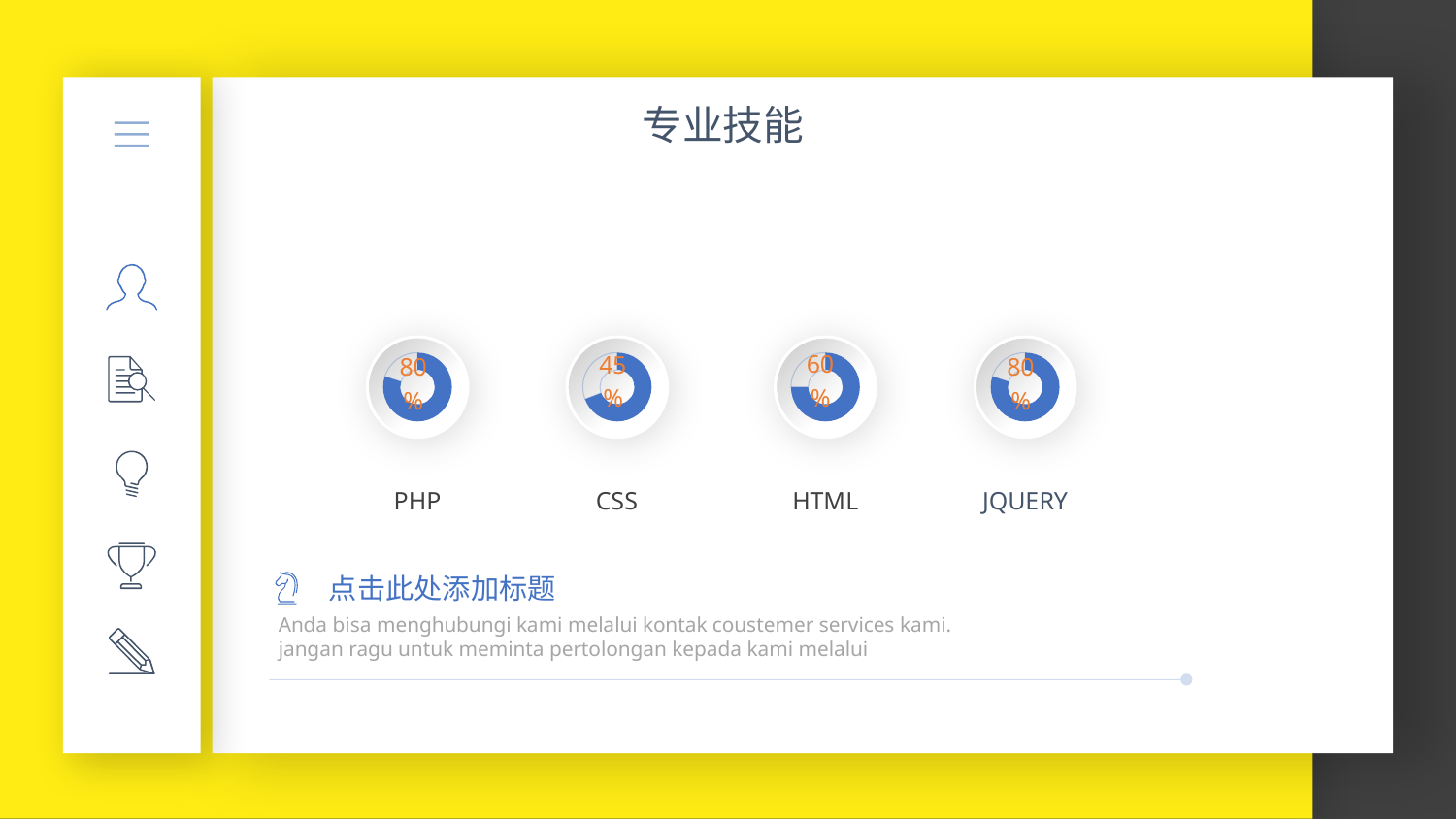
Which is larger, the HTML percentage or the CSS percentage? HTML How many donut charts are shown on the slide? 4 What percentage is shown on the PHP donut chart? 80% What percentage is shown on the CSS donut chart? 45% What percentage is shown on the JQUERY donut chart? 80% Which skill has the lowest percentage among the four donut charts? CSS What percentage is shown on the HTML donut chart? 60% Which two skills share the same percentage value? PHP and JQUERY What is the difference between the PHP percentage and the CSS percentage? 35% What is the difference between the JQUERY percentage and the HTML percentage? 20% What is the title of the slide containing the skill charts? 专业技能 What kind of chart is used to show each skill level? Donut chart